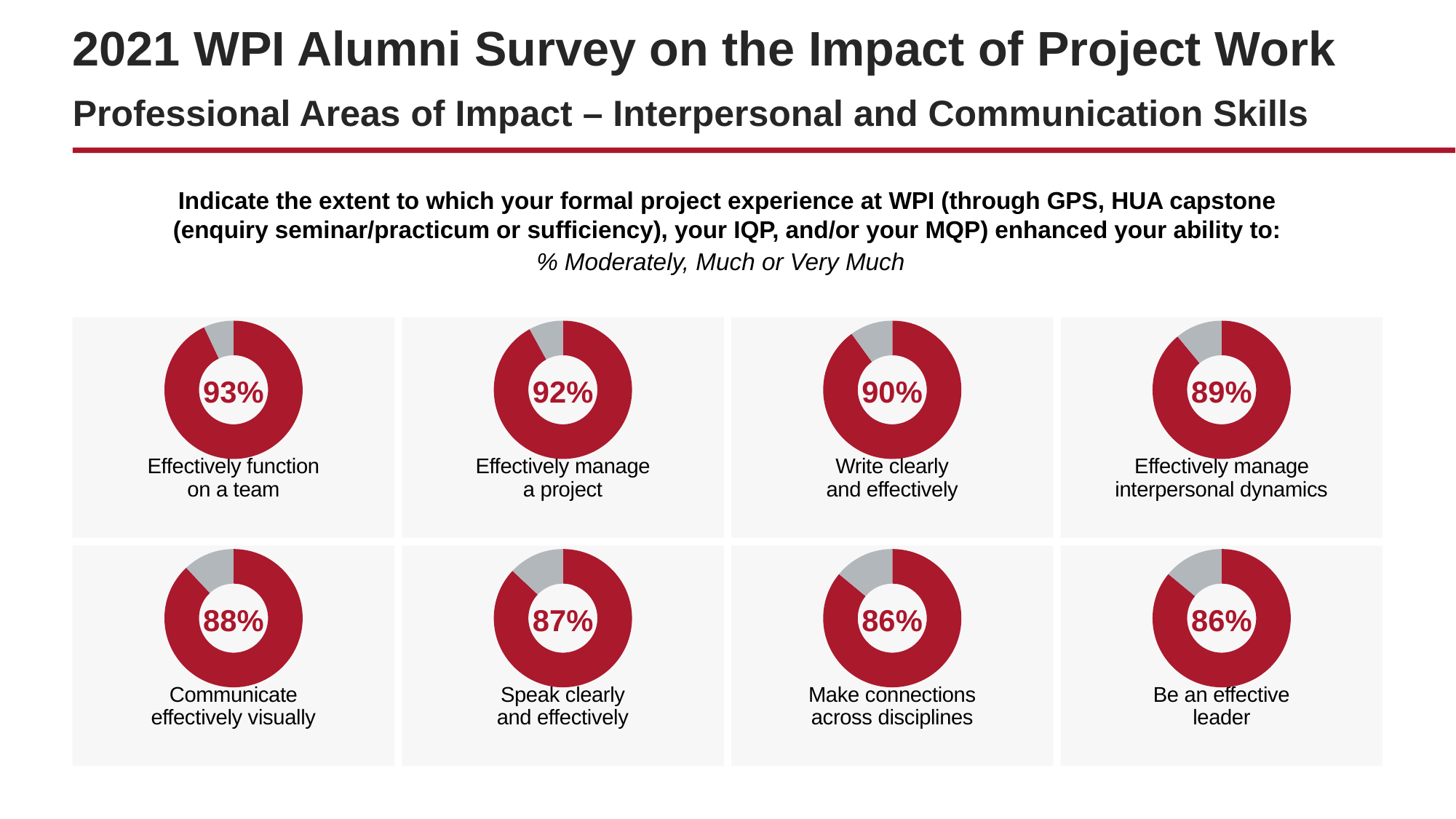
What kind of chart is used to display each percentage on the slide? Donut chart What colour is used for the filled (percentage) portion of each donut chart? Red Which has the larger percentage: the "Write clearly and effectively" chart or the "Speak clearly and effectively" chart? Write clearly and effectively What percentage is shown in the donut chart labelled "Speak clearly and effectively"? 87% Which two skill areas share the lowest percentage on the slide? Make connections across disciplines and Be an effective leader Which skill area has the highest percentage across the donut charts on the slide? Effectively function on a team What percentage is shown in the donut chart labelled "Effectively function on a team"? 93% How many donut charts are shown on the slide? 8 What percentage is shown in the donut chart labelled "Be an effective leader"? 86% What is the difference in percentage points between the "Effectively function on a team" chart and the "Be an effective leader" chart? 7 What is the difference in percentage points between the "Effectively manage a project" chart and the "Communicate effectively visually" chart? 4 What percentage is shown in the donut chart labelled "Write clearly and effectively"? 90%